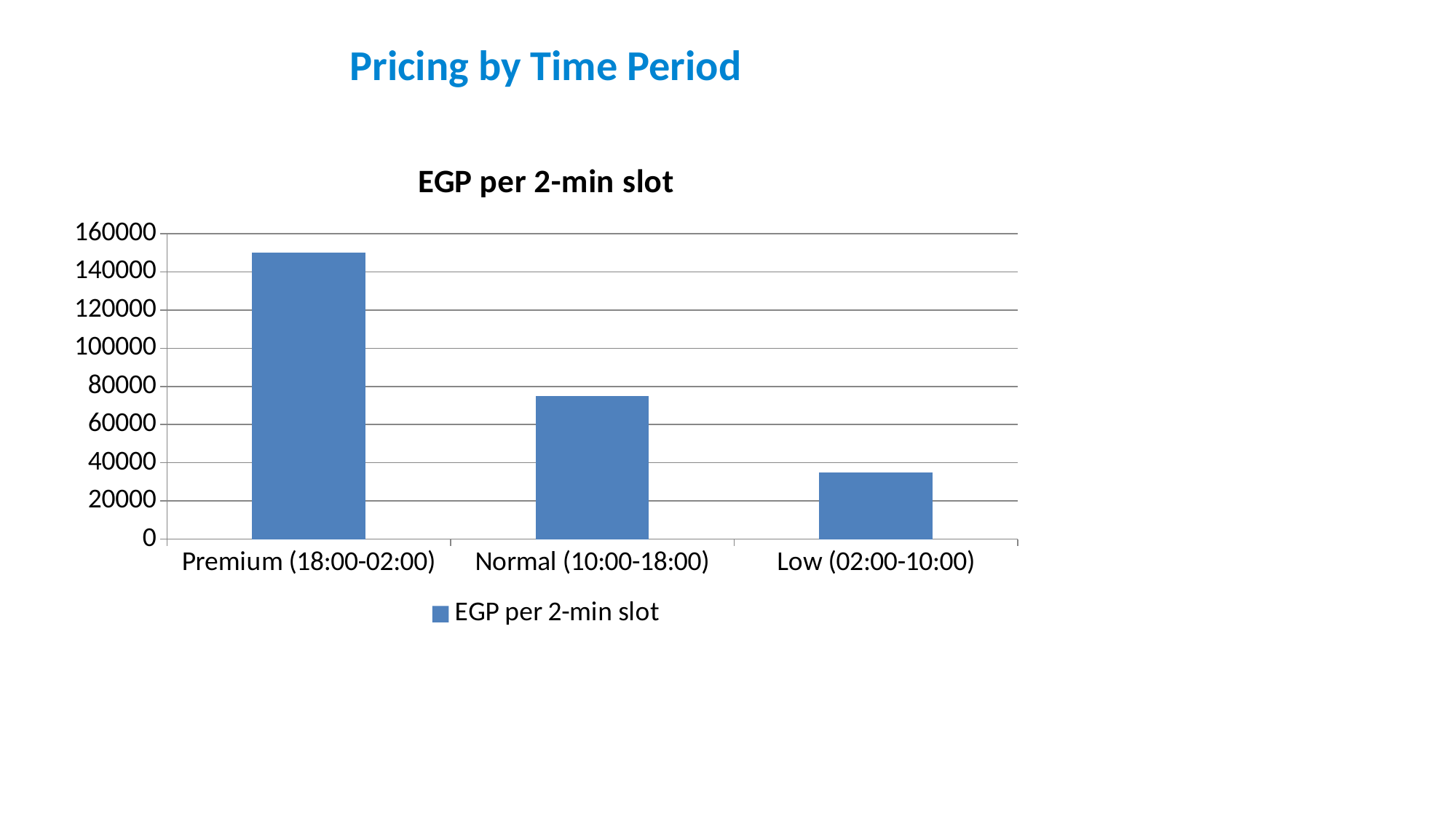
Which has a lower EGP per 2-min slot, Normal (10:00-18:00) or Low (02:00-10:00)? Low (02:00-10:00) Is the value for Low (02:00-10:00) greater or less than 20000? greater Which time period has the highest EGP per 2-min slot? Premium (18:00-02:00) Do the values rise or fall from left to right across the time periods? fall What kind of chart is shown on the slide? bar chart Is the value for Normal (10:00-18:00) greater or less than 80000? less Which has a higher EGP per 2-min slot, Premium (18:00-02:00) or Normal (10:00-18:00)? Premium (18:00-02:00) Which time period has the lowest EGP per 2-min slot? Low (02:00-10:00) Is the value for Low (02:00-10:00) greater or less than 40000? less How many series does the legend list? 1 How many time periods are shown on the chart? 3